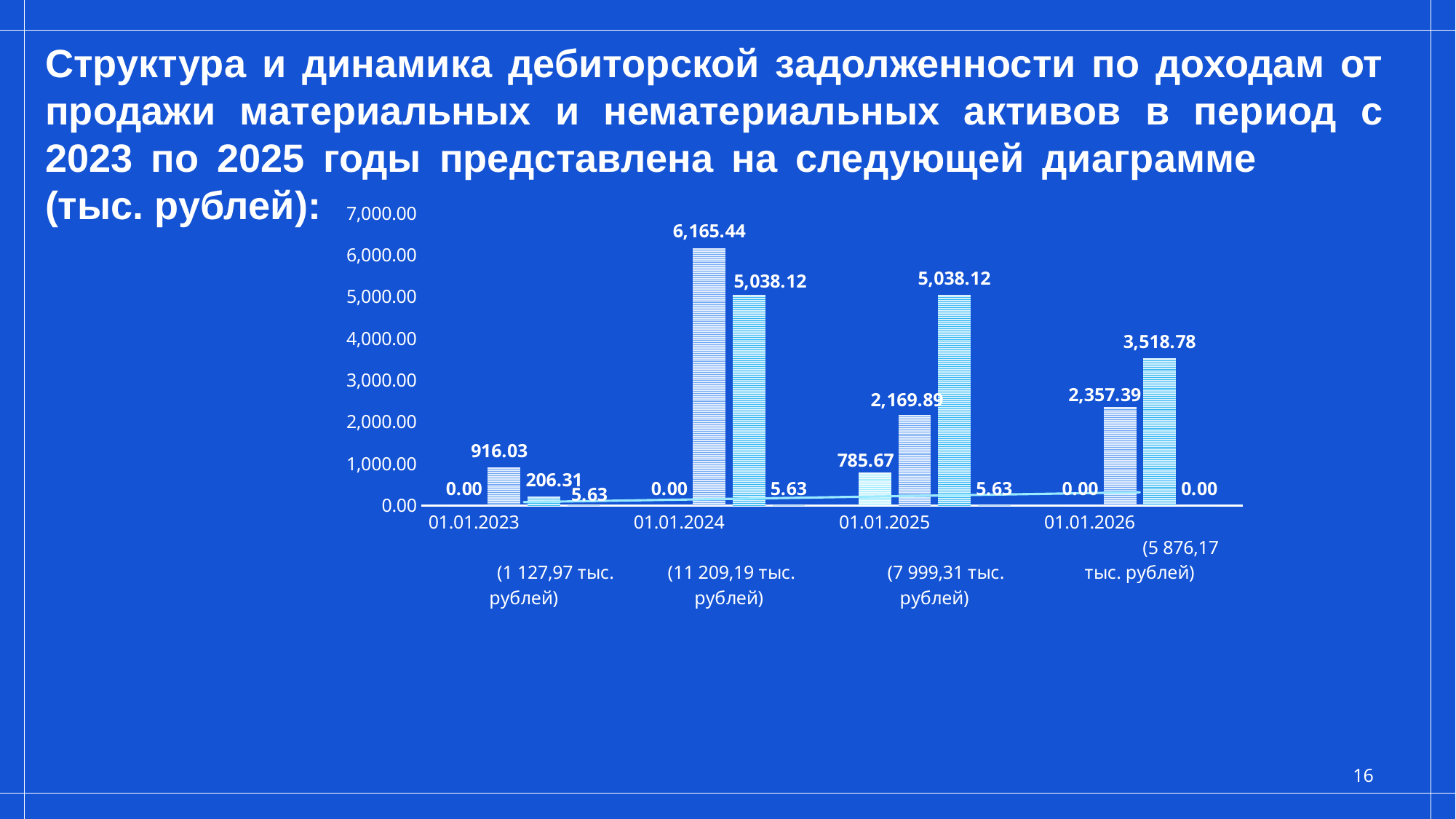
What is the value of the tallest bar at 01.01.2026? 3,518.78 Which date on the x axis has the highest labeled value in the chart? 01.01.2024 At 01.01.2026, which is larger: the bar labeled 2,357.39 or the bar labeled 3,518.78? 3,518.78 What kind of chart is shown on the slide? bar chart What is the highest tick value shown on the vertical axis? 7,000.00 How many dates are shown on the x axis of the chart? 4 What is the difference between the bars labeled 3,518.78 and 2,357.39 at 01.01.2026? 1,161.39 What is the value of the first bar at 01.01.2025? 785.67 What text is printed below the 01.01.2024 label on the x axis? (11 209,19 тыс. рублей) What is the difference between the two tallest bars at 01.01.2024 (6,165.44 and 5,038.12)? 1,127.32 What is the value of the tallest bar at 01.01.2024? 6,165.44 What is the value of the second bar (the tallest one) at 01.01.2023? 916.03